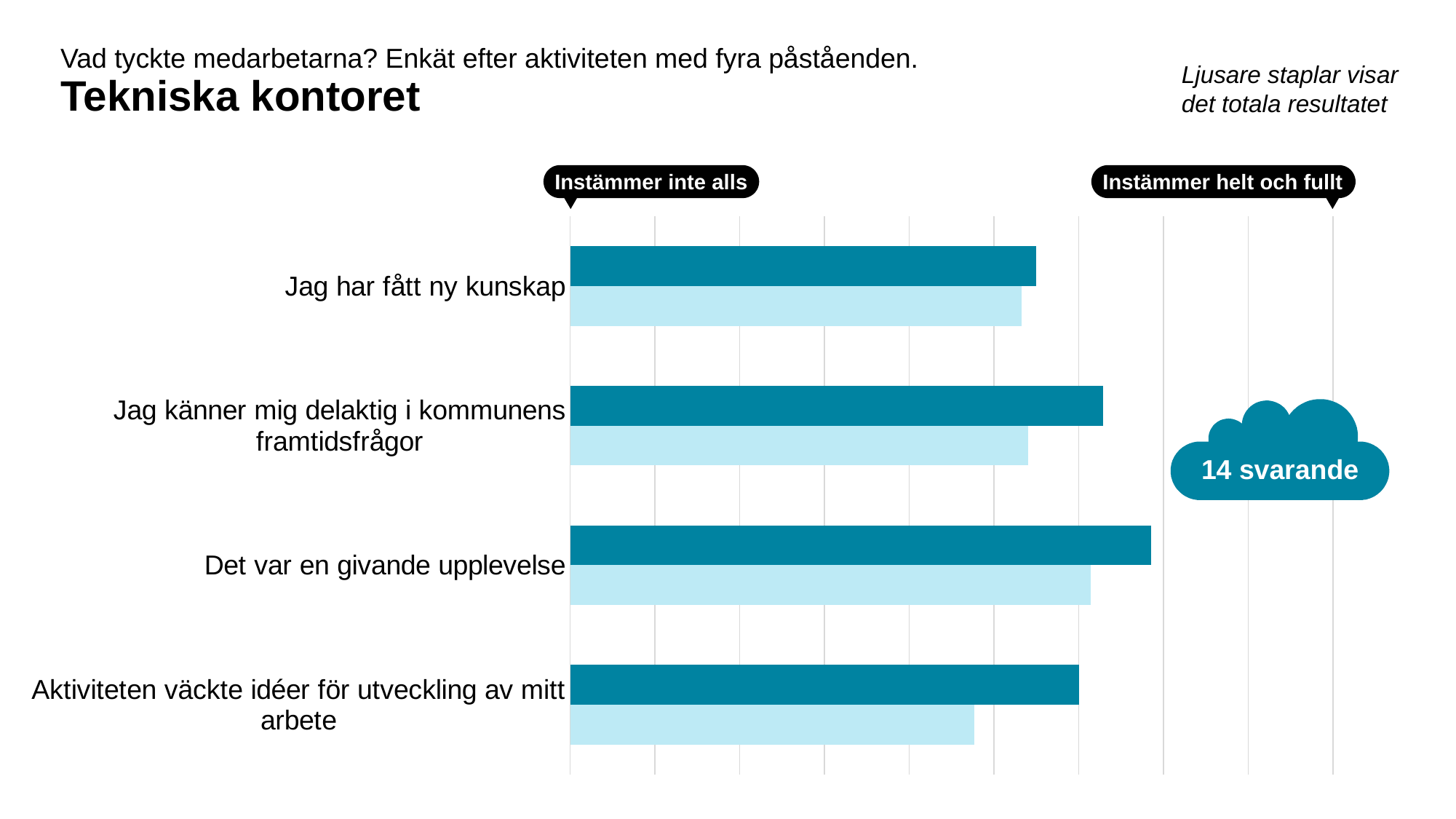
How many statements (categories) are plotted in the chart? 4 Which statement has the shortest light bar? Aktiviteten väckte idéer för utveckling av mitt arbete Which statement has the longest light bar? Det var en givande upplevelse For 'Jag har fått ny kunskap', which bar is longer, the dark bar or the light bar? The dark bar Which statement has the shortest dark bar? Jag har fått ny kunskap According to the note on the slide, what do the lighter bars show? Det totala resultatet Which dark bar is longer: 'Jag känner mig delaktig i kommunens framtidsfrågor' or 'Det var en givande upplevelse'? Det var en givande upplevelse How many respondents (svarande) are indicated on the slide? 14 svarande Which statement has the longest dark bar? Det var en givande upplevelse How many bars are shown for each statement in the chart? 2 What kind of chart is shown on the slide? Bar chart